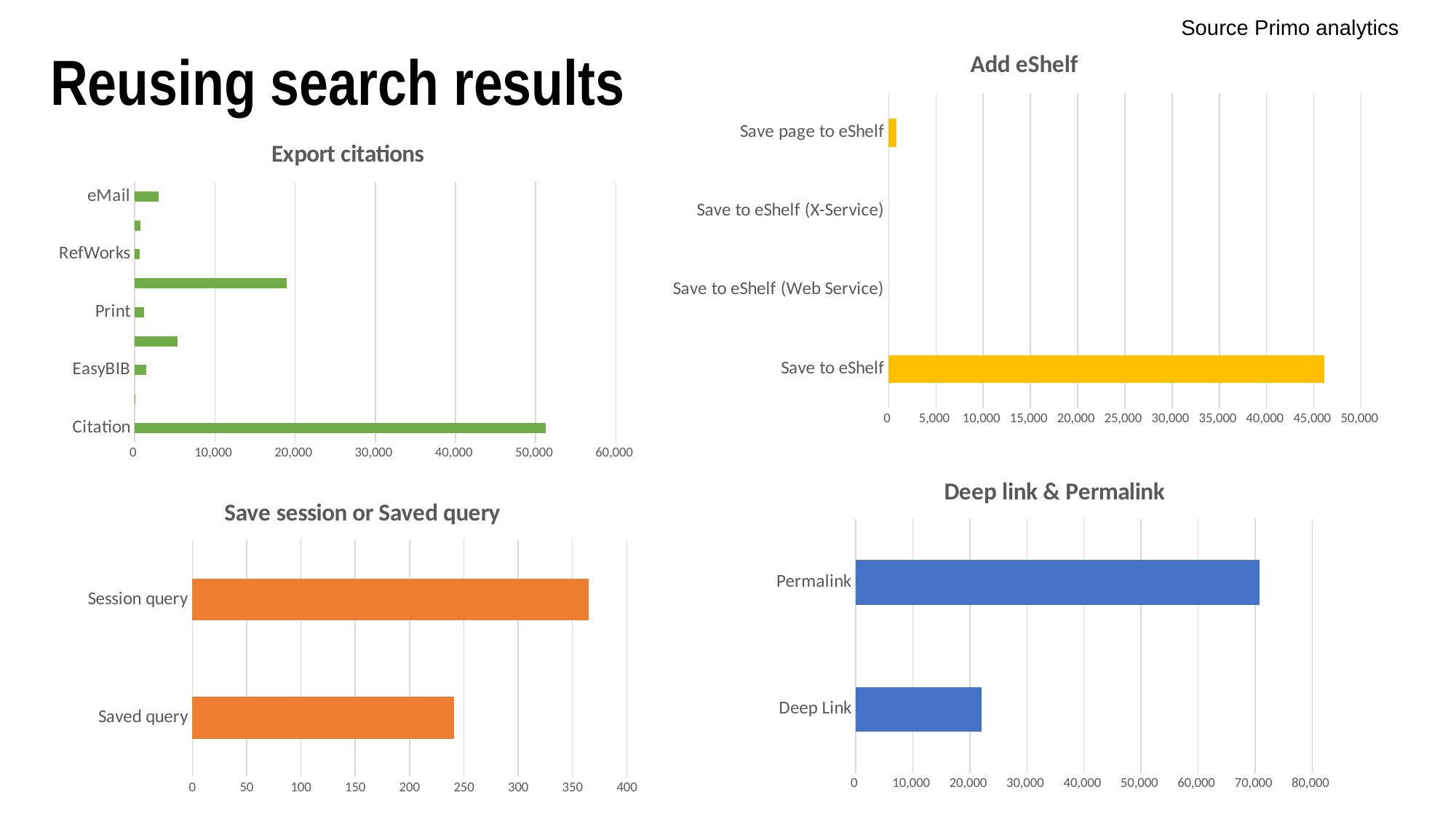
In the Export citations chart, is the value for eMail greater or less than 10,000? less In the Add eShelf chart, which category has the highest value? Save to eShelf In the Deep link & Permalink chart, is the value for Permalink greater or less than 60,000? greater In the Add eShelf chart, is the value for Save to eShelf greater or less than 40,000? greater How many categories are shown in the Add eShelf chart? 4 In the Deep link & Permalink chart, which category has the lowest value? Deep Link How many categories are shown in the Save session or Saved query chart? 2 In the Export citations chart, which category has the highest value? Citation What type of chart is the Deep link & Permalink chart? Bar chart In the Save session or Saved query chart, which is larger, Session query or Saved query? Session query